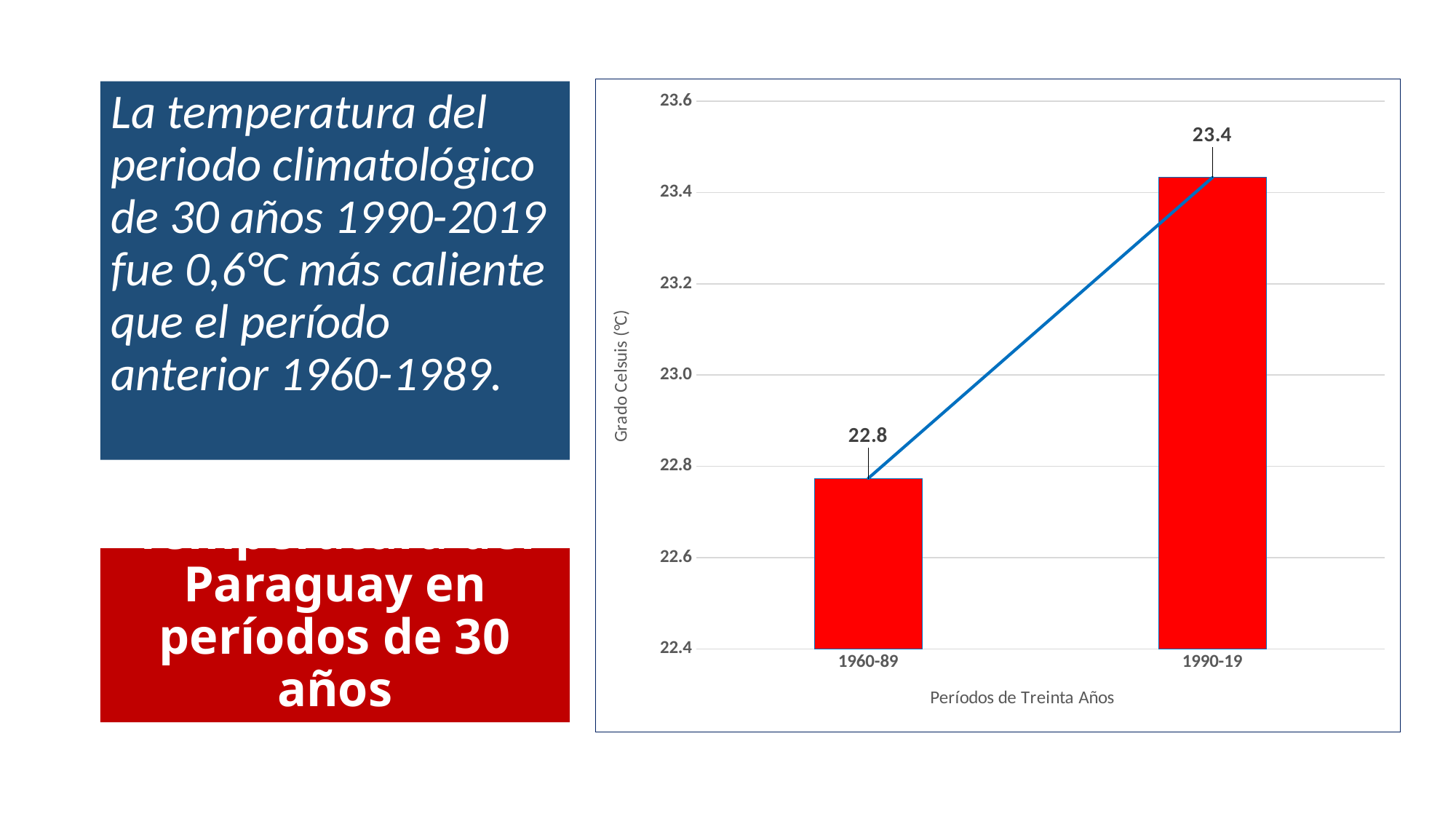
What is the value for the 1990-19 period? 23.4 What is the value for the 1960-89 period? 22.8 Is the value for 1960-89 greater or less than 23.0? less Is the value for 1990-19 greater or less than 23.0? greater Which period has the highest temperature? 1990-19 What kind of chart is this? bar chart Which period has the lowest temperature? 1960-89 Which is larger, the value for 1960-89 or the value for 1990-19? 1990-19 How many periods are shown on the x axis? 2 What is the difference between the values for 1990-19 and 1960-89? 0.6 What is the label of the y axis? Grado Celsuis (°C) Do the values rise or fall from 1960-89 to 1990-19? rise